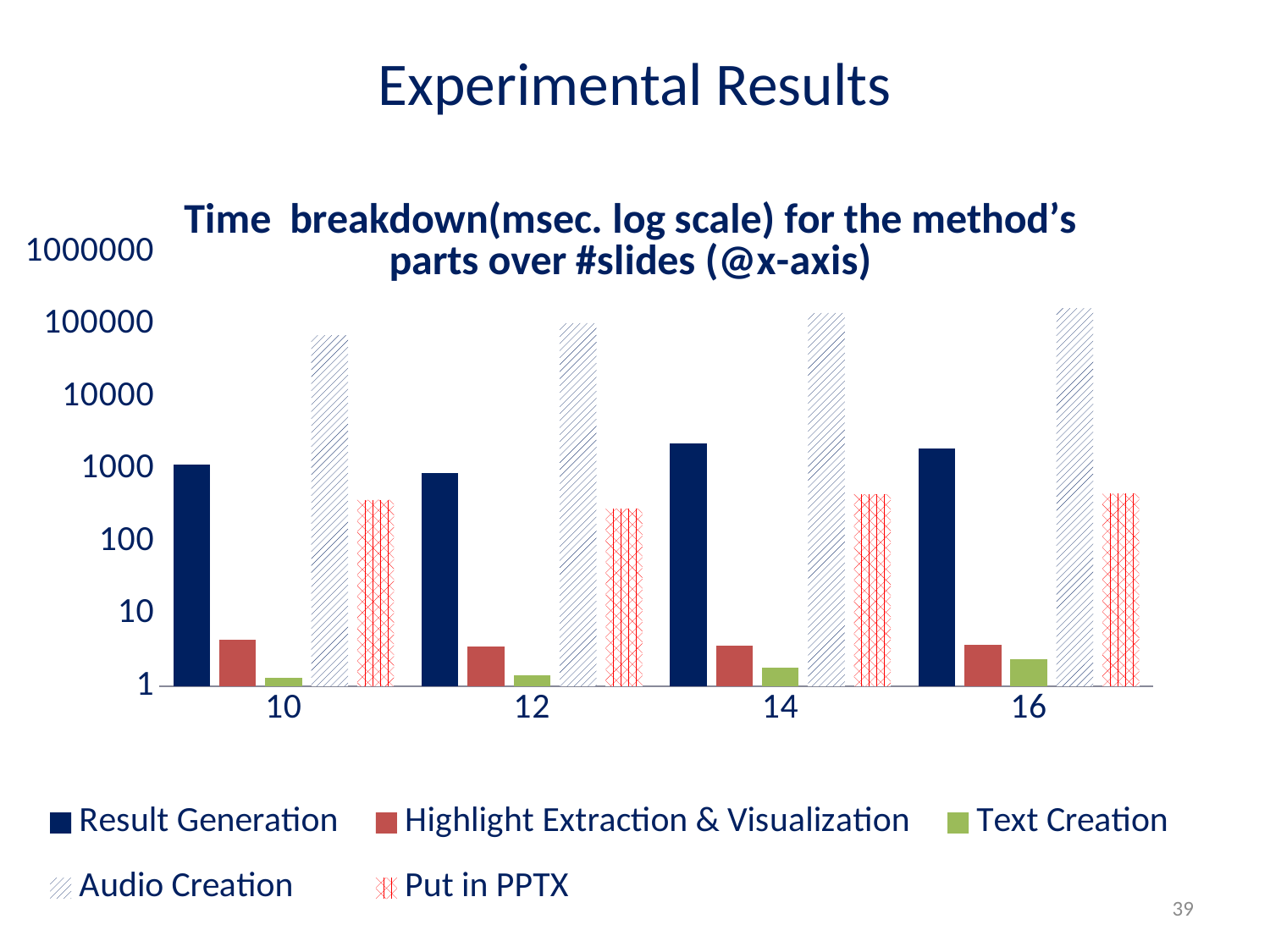
How many categories (numbers of slides) are shown on the x axis? 4 Which series has the shortest bar for 14 slides? Text Creation What kind of chart is shown on the slide? bar chart How many series does the legend list? 5 Which series has the tallest bar for 10 slides? Audio Creation Is the value for Result Generation at 12 slides greater or less than 1000? less Is the value for Put in PPTX at 10 slides greater or less than 100? greater Is the value for Audio Creation at 16 slides greater or less than 100000? greater Does the Audio Creation value rise or fall as the number of slides increases from 10 to 16? rise Which is larger, Audio Creation at 10 slides or Audio Creation at 12 slides? 12 slides